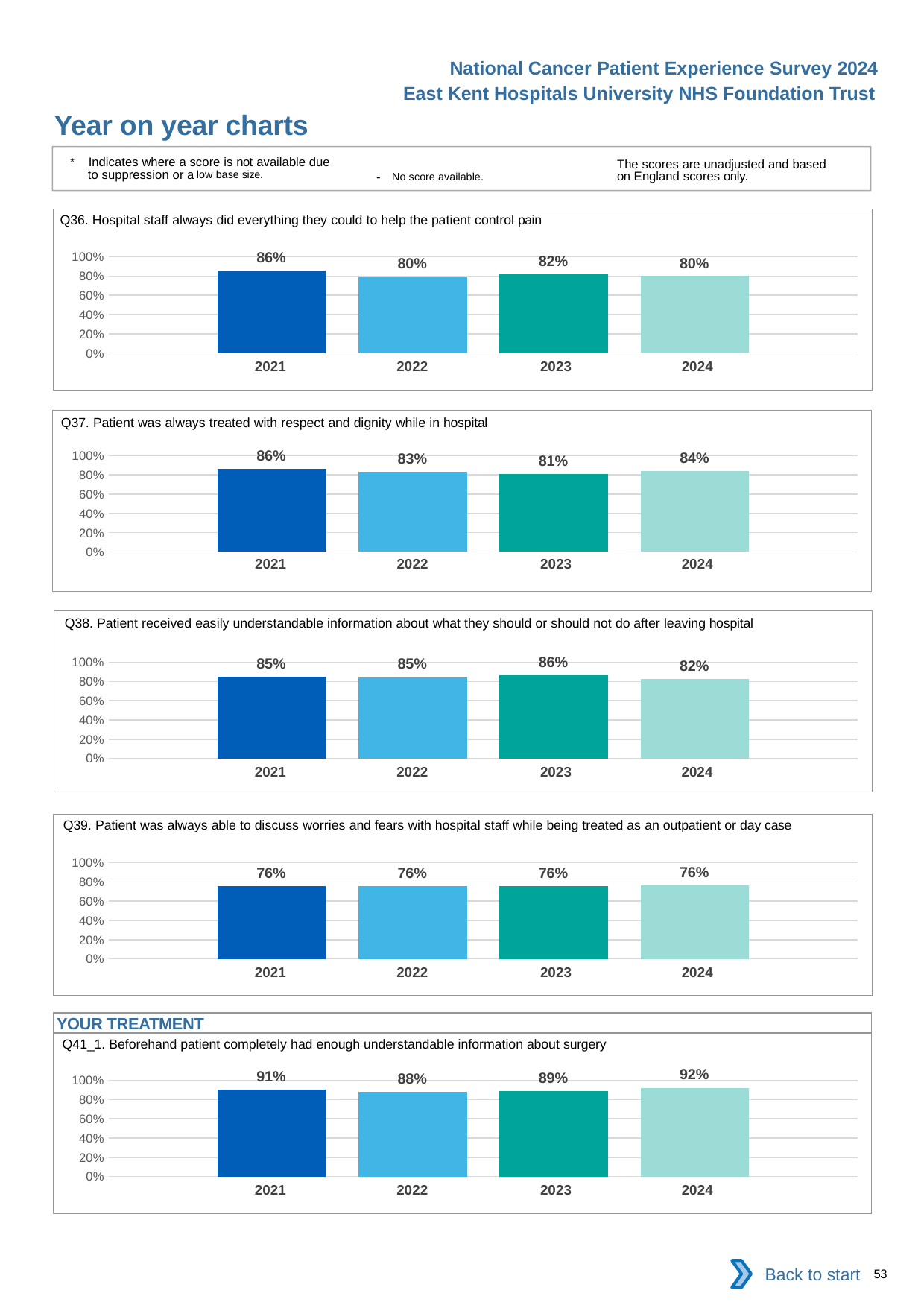
In the Q39 chart (patient was always able to discuss worries and fears with hospital staff), what is the value for 2022? 76% In the Q36 chart, which year has the lowest value? 2022 and 2024 (both 80%) What kind of chart is used for Q37? Bar chart In the Q37 chart, what is the difference between the 2021 value and the 2023 value? 5 percentage points In the Q39 chart, do the values rise, fall or stay the same from 2021 to 2024? Stay the same In the Q41_1 chart, is the value for 2022 larger or smaller than the value for 2023? Smaller In the Q38 chart, what is the value for 2024? 82% In the Q41_1 chart (beforehand patient completely had enough understandable information about surgery), which year has the highest value? 2024 In the Q37 chart (patient was always treated with respect and dignity while in hospital), what is the value for 2024? 84% How many years are plotted in the Q36 chart? 4 In the Q38 chart (patient received easily understandable information about what they should or should not do after leaving hospital), which year has the highest value? 2023 In the Q36 chart (hospital staff always did everything they could to help the patient control pain), what is the value for 2021? 86%